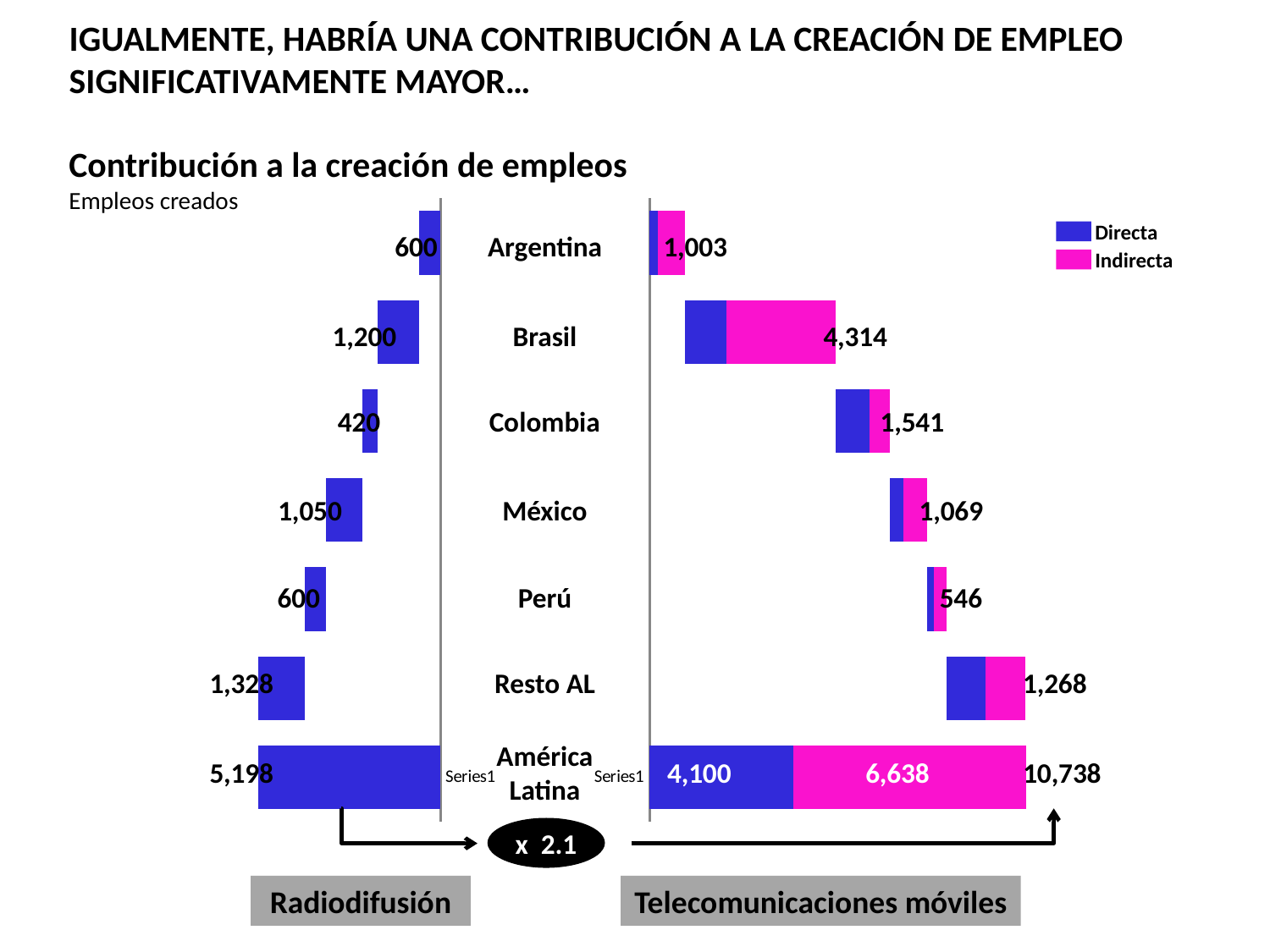
In the Telecomunicaciones móviles chart, what is the value for Colombia? 1,541 How many series does the legend list? 2 How many categories are shown in the Radiodifusión chart? 7 In the Radiodifusión chart, which is larger, the value for Resto AL or the value for México? Resto AL In the Telecomunicaciones móviles chart, what is the Directa value for América Latina? 4,100 In the Telecomunicaciones móviles chart, what is the difference between the values for Brasil and Argentina? 3,311 In the Telecomunicaciones móviles chart, which category has the highest value? América Latina In the Telecomunicaciones móviles chart, what is the total of the stacked bar for América Latina? 10,738 In the Telecomunicaciones móviles chart, which category has the lowest value? Perú What kind of chart is the Telecomunicaciones móviles chart? Bar chart In the Radiodifusión chart, which category has the lowest value? Colombia In the Radiodifusión chart, how many jobs are created for Brasil? 1,200